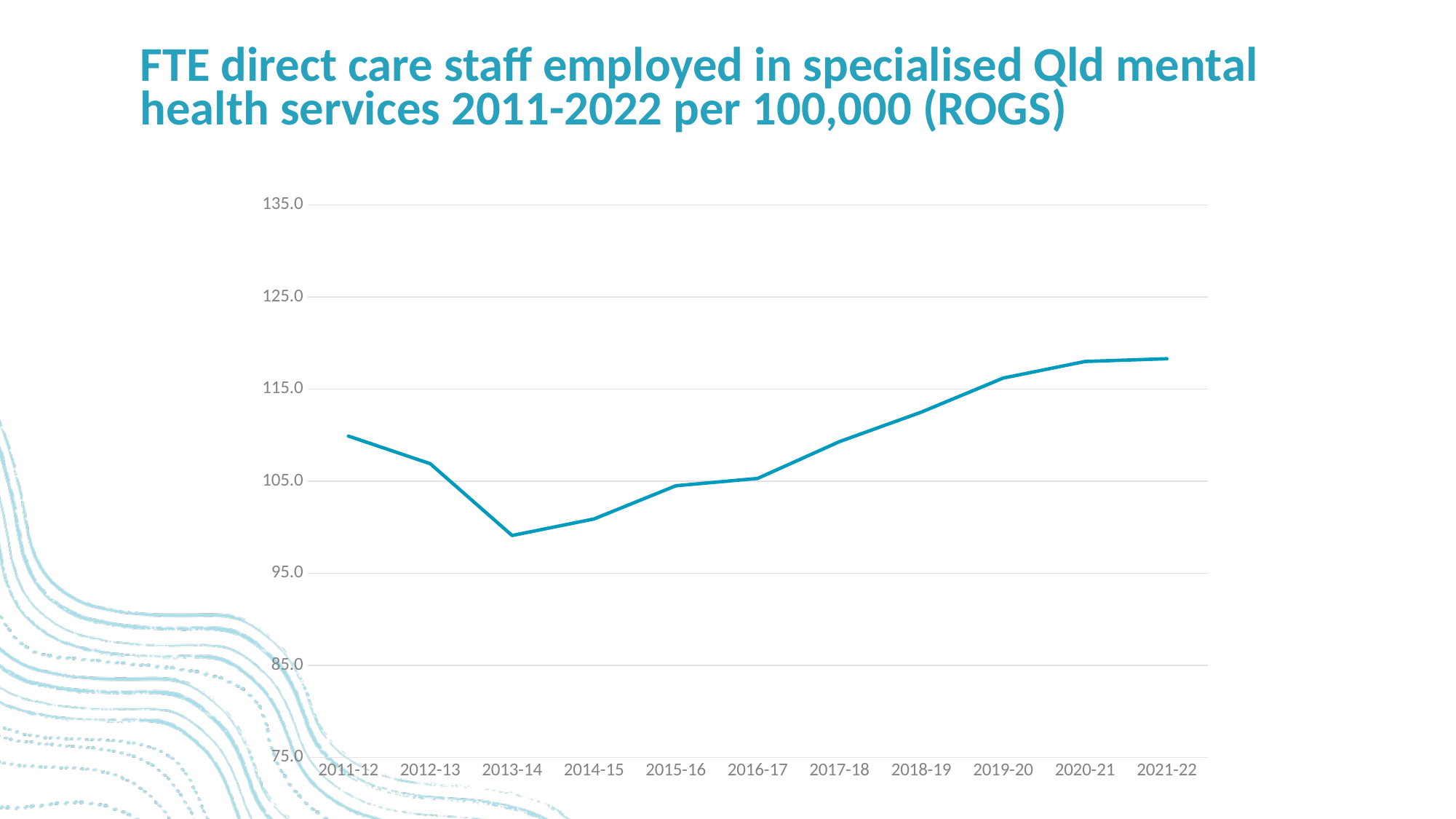
Is the value for 2013-14 greater or less than 105? less Which is larger, the value for 2011-12 or the value for 2013-14? 2011-12 What is the title of the chart? FTE direct care staff employed in specialised Qld mental health services 2011-2022 per 100,000 (ROGS) Which year has the lowest value on the chart? 2013-14 Is the value for 2020-21 greater or less than 115? greater How many financial years are plotted on the x axis? 11 Is the value for 2014-15 greater or less than 105? less What kind of chart is shown on the slide? line chart Do the values rise or fall from 2013-14 to 2021-22? rise Which is larger, the value for 2021-22 or the value for 2011-12? 2021-22